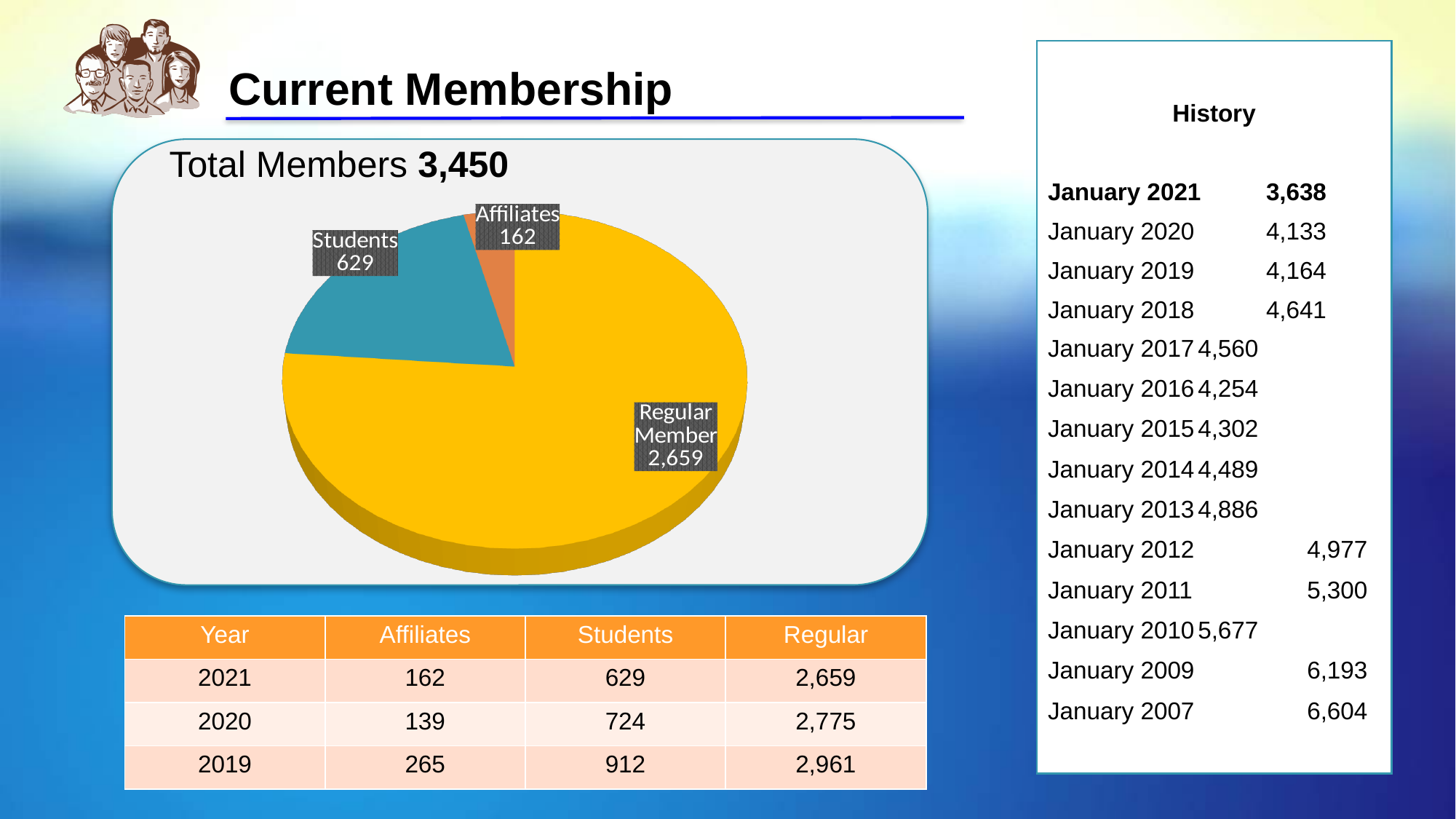
Which is larger in the pie chart, Students or Affiliates? Students What is the value for Affiliates in the pie chart? 162 How many slices does the pie chart have? 3 Which category has the largest slice in the pie chart? Regular Member What total number of members is stated above the pie chart? 3,450 What is the difference between the Regular Member and Students values in the pie chart? 2,030 Which category has the smallest slice in the pie chart? Affiliates What is the value for Students in the pie chart? 629 What kind of chart is shown on the slide? Pie chart What is the value for Regular Member in the pie chart? 2,659 What is the difference between the Students and Affiliates values in the pie chart? 467 What share of the pie chart does the Regular Member slice represent, to the nearest whole percent? 77%